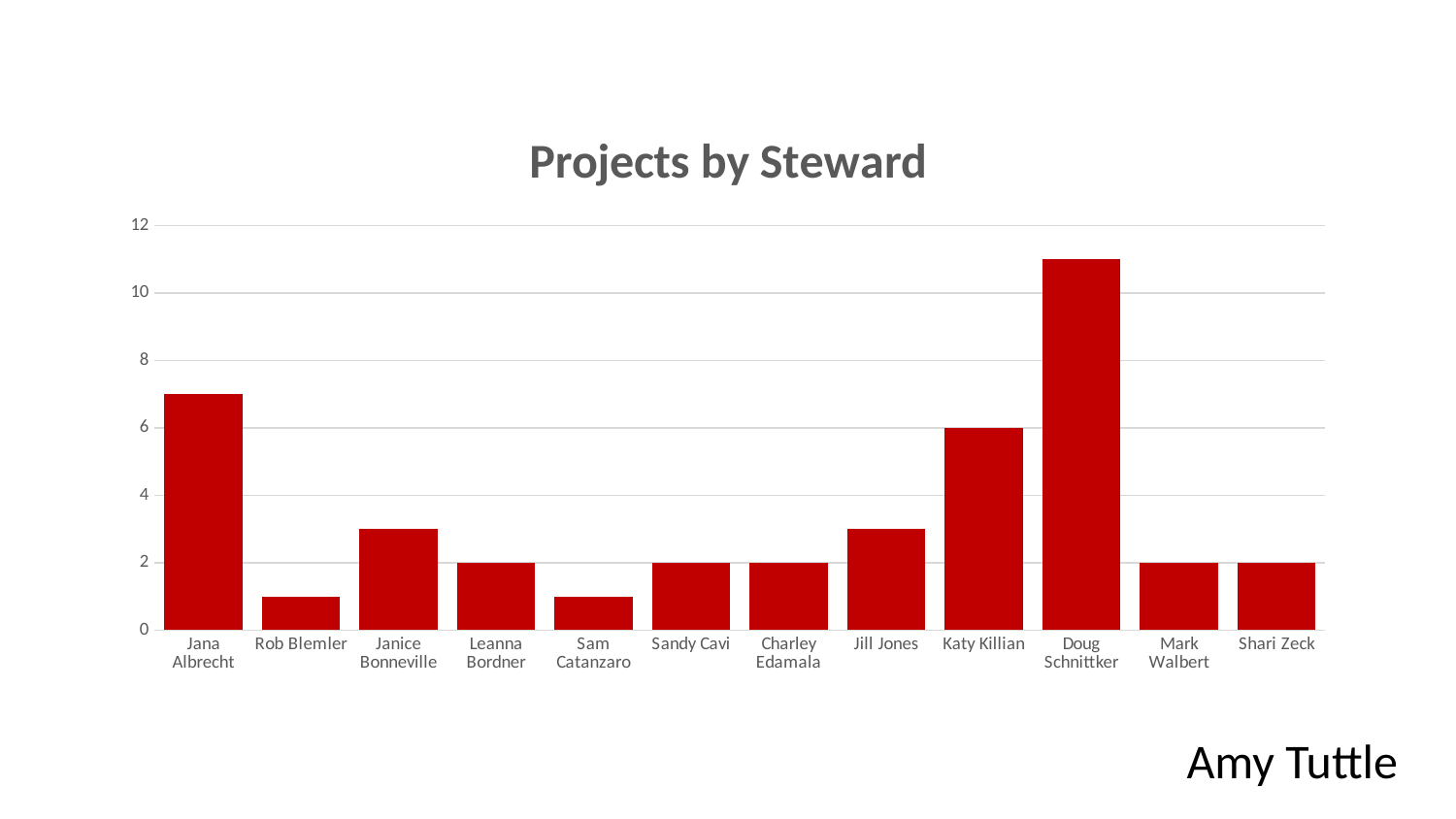
Is the value for Rob Blemler greater or less than 2? less Is the value for Doug Schnittker greater or less than 10? greater What is the title of the chart? Projects by Steward Which steward has the highest number of projects? Doug Schnittker Which is larger, the value for Jana Albrecht or the value for Katy Killian? Jana Albrecht Is the value for Jana Albrecht greater or less than 6? greater What is the value for Katy Killian? 6 What kind of chart is shown on the slide? bar chart How many stewards are shown on the x axis of the chart? 12 What is the difference between the values for Katy Killian and Leanna Bordner? 4 What is the value for Shari Zeck? 2 What is the value for Leanna Bordner? 2